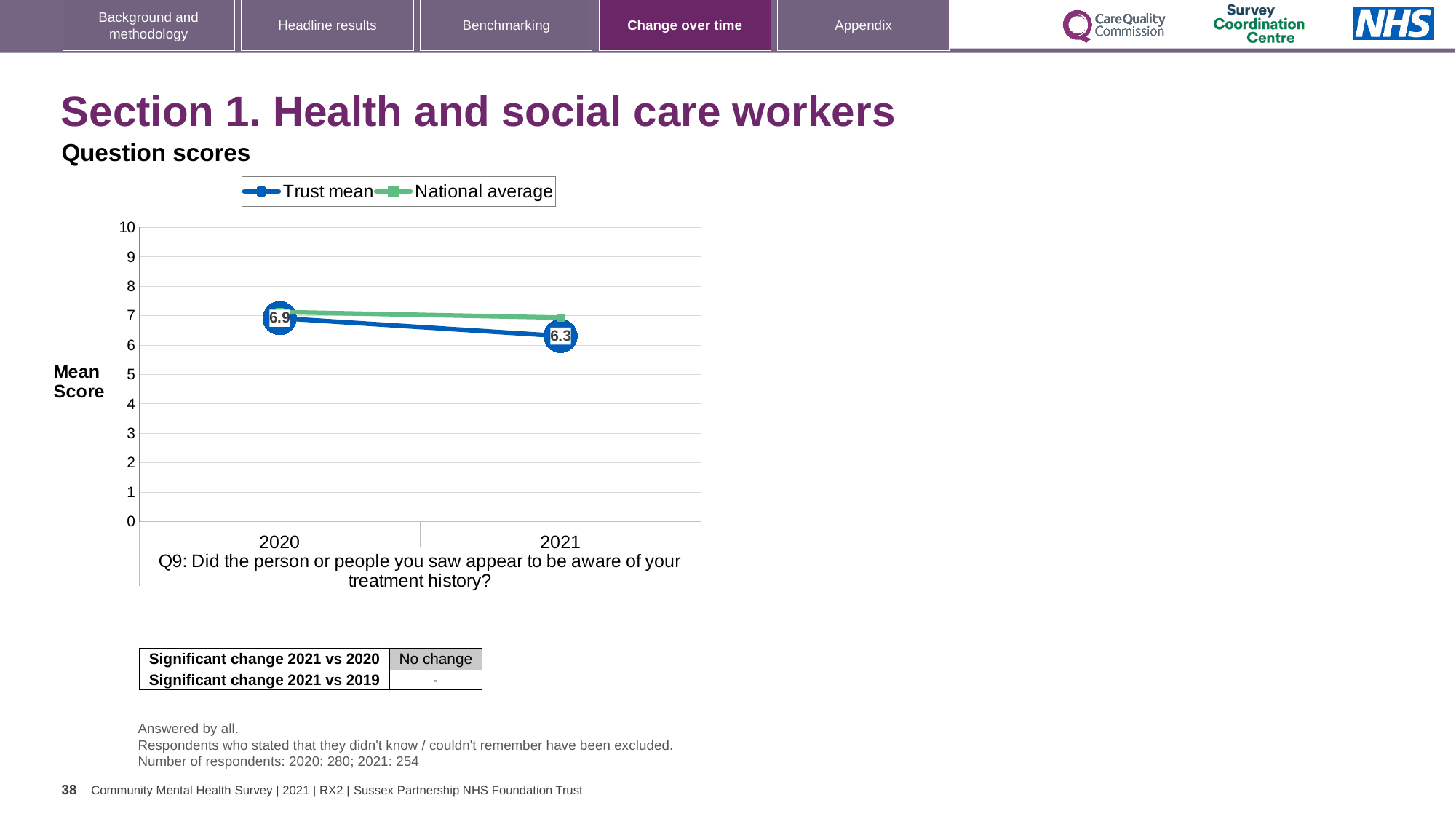
How many years are plotted on the x axis? 2 What is the label on the y axis of the chart? Mean Score What kind of chart is shown on the slide? line chart What is the Trust mean score for 2021? 6.3 Is the National average value for 2021 greater or less than 5? greater Does the Trust mean rise or fall from 2020 to 2021? fall In 2021, which series has the higher value, Trust mean or National average? National average Is the Trust mean value for 2021 greater or less than 7? less By how much did the Trust mean score fall from 2020 to 2021? 0.6 Which year has the higher Trust mean score, 2020 or 2021? 2020 How many series does the legend list? 2 What is the Trust mean score for 2020? 6.9